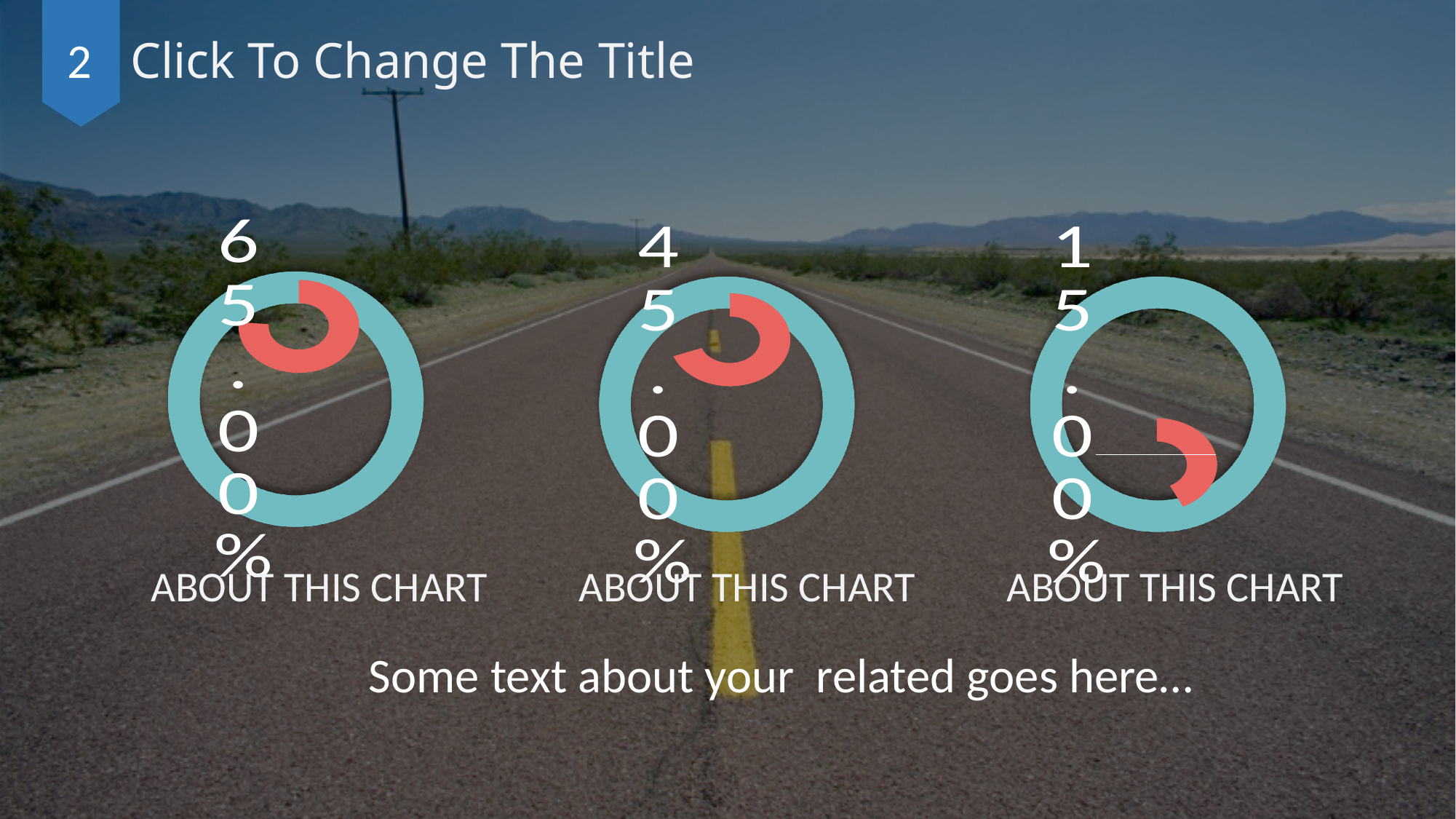
What percentage is shown on the right donut chart? 15.00% Which shows a larger percentage, the middle chart or the right chart? The middle chart What colour is the filled (value) segment in each donut chart? Red What percentage is shown on the left donut chart? 65.00% Which of the three donut charts shows the highest percentage? The left chart Which of the three donut charts shows the lowest percentage? The right chart What is the difference between the percentage on the left chart and the percentage on the middle chart? 20.00% What is the difference between the percentage on the left chart and the percentage on the right chart? 50.00% What percentage is shown on the middle donut chart? 45.00% How many donut charts are on the slide? 3 What type of chart is used for the three figures on the slide? Donut chart What caption appears below each of the three charts? ABOUT THIS CHART